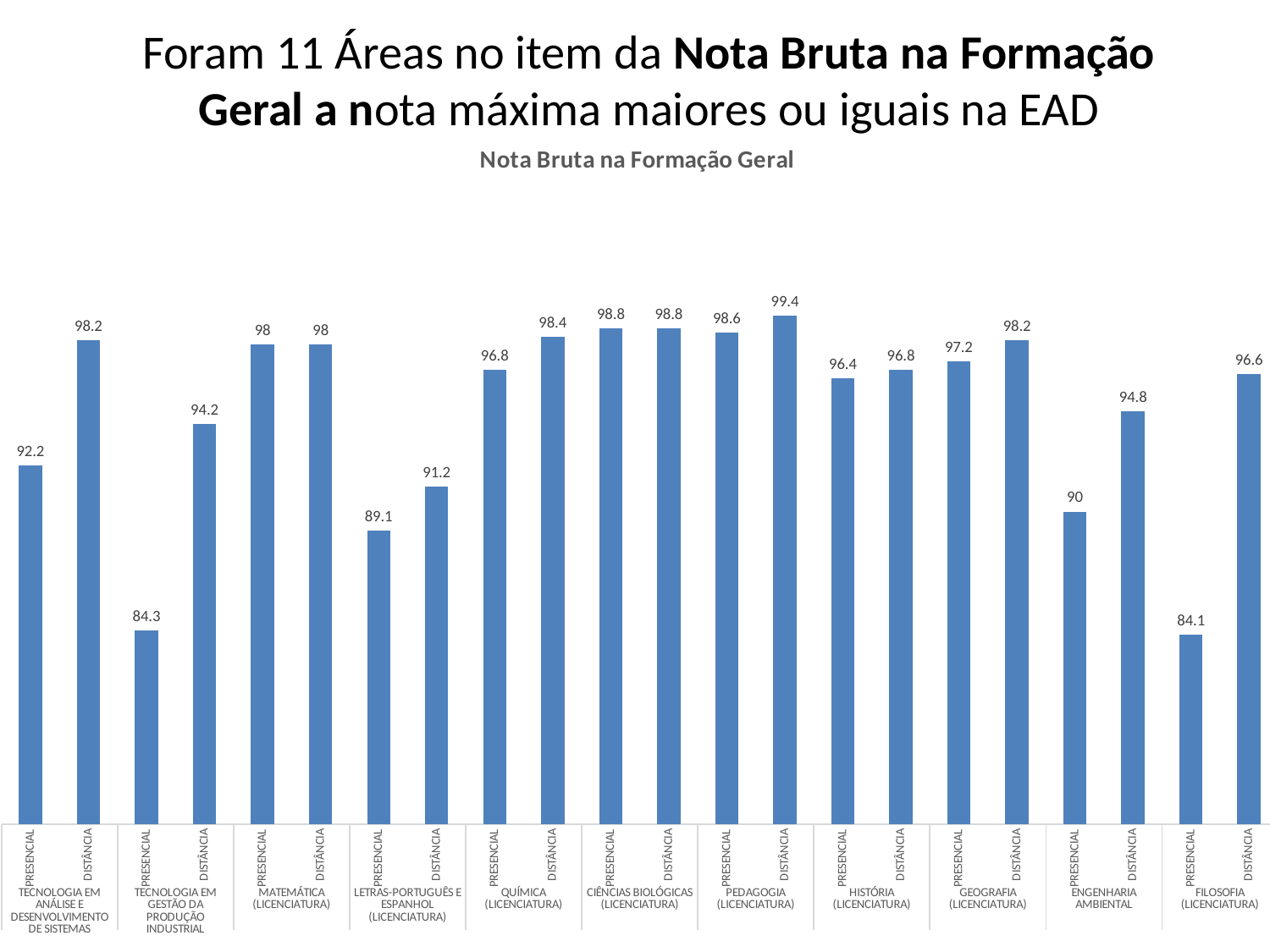
What is the difference between the DISTÂNCIA and PRESENCIAL values for Engenharia Ambiental? 4.8 Are the PRESENCIAL and DISTÂNCIA values for Matemática (Licenciatura) equal, and if so what is the value? Yes, 98 What is the value of the DISTÂNCIA bar for Pedagogia (Licenciatura)? 99.4 What is the difference between the DISTÂNCIA and PRESENCIAL values for Filosofia (Licenciatura)? 12.5 How many areas (categories) are shown on the x axis of the chart? 11 Which bar has the highest value in the chart? Pedagogia (Licenciatura) DISTÂNCIA, 99.4 What is the value of the PRESENCIAL bar for Tecnologia em Gestão da Produção Industrial? 84.3 What type of chart is shown on the slide? Bar chart What is the value of the DISTÂNCIA bar for Filosofia (Licenciatura)? 96.6 Which is larger for Química (Licenciatura): the PRESENCIAL value or the DISTÂNCIA value? DISTÂNCIA How many bars are plotted in the chart in total? 22 Which bar has the lowest value in the chart? Filosofia (Licenciatura) PRESENCIAL, 84.1